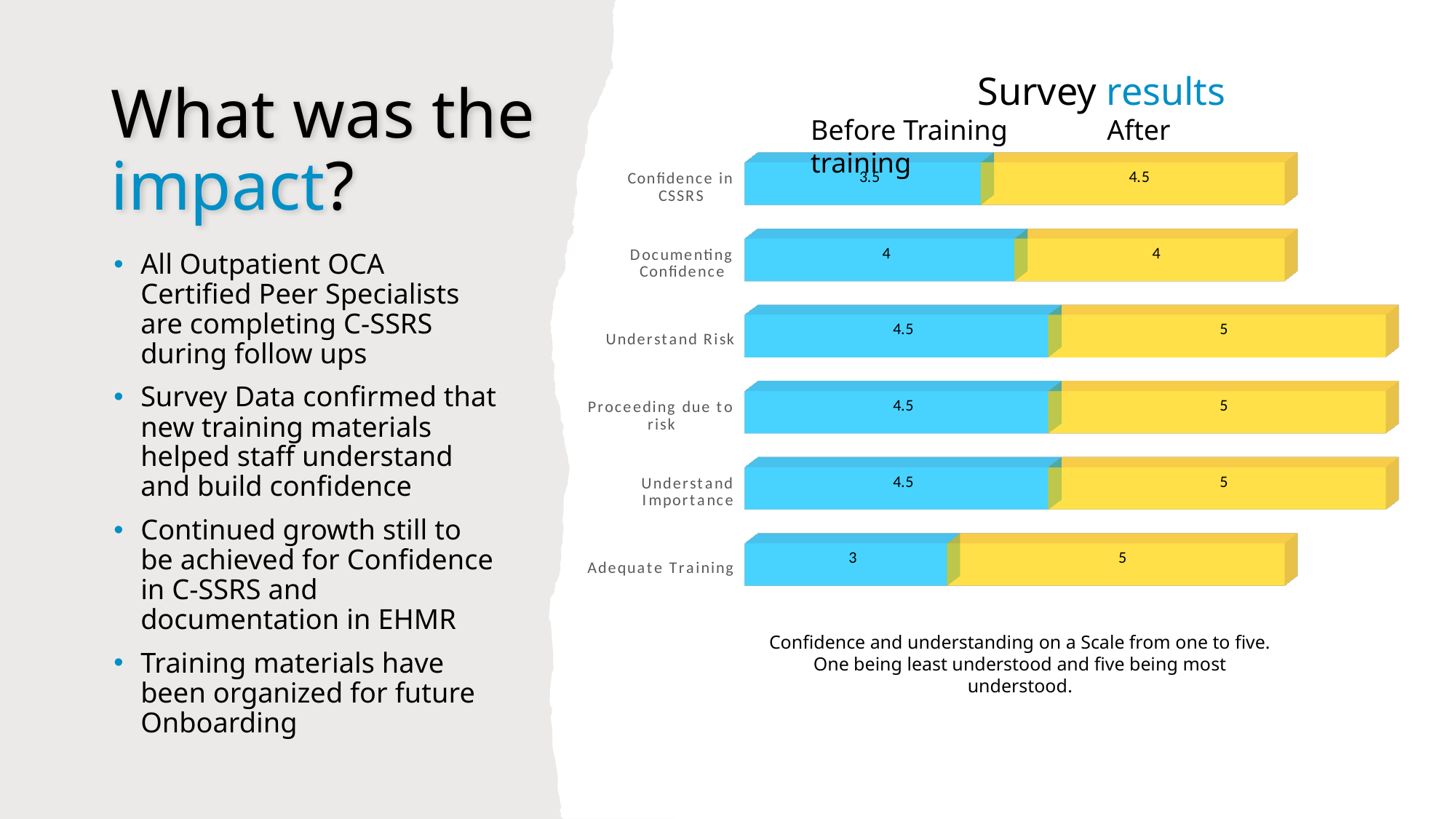
Which category has the lowest Before Training value? Adequate Training How many categories are shown in the chart? 6 What is the After training value for Adequate Training? 5 What is the Before Training value for Documenting Confidence? 4 What is the difference between the After training and Before Training values for Adequate Training? 2 What is the total of the stacked bar for Understand Importance? 9.5 Which category has the lowest After training value? Documenting Confidence How many series does the chart show? 2 What is the Before Training value for Confidence in CSSRS? 3.5 What kind of chart is shown on the slide? bar chart What is the difference between the After training and Before Training values for Confidence in CSSRS? 1 Is the Before Training value for Understand Risk larger or smaller than the Before Training value for Adequate Training? larger